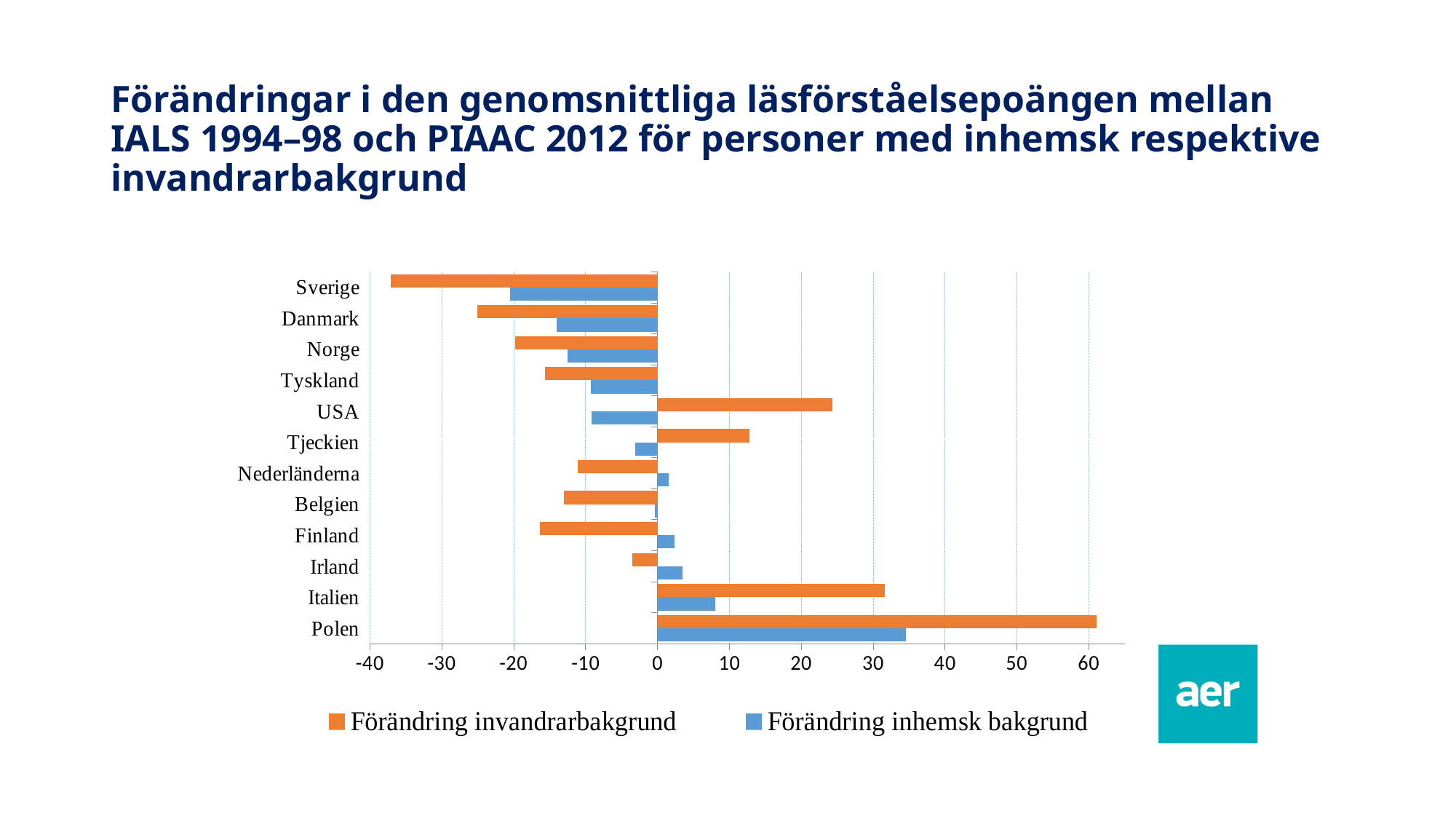
Is the Förändring invandrarbakgrund value for USA greater or less than 20? greater Which has the larger Förändring invandrarbakgrund value, Italien or USA? Italien Is the Förändring invandrarbakgrund value for Polen greater or less than 50? greater How many countries are listed on the chart? 12 Which country has the highest value for Förändring inhemsk bakgrund? Polen Which colour represents Förändring invandrarbakgrund in the legend? Orange Is the Förändring invandrarbakgrund value for Sverige greater or less than -30? less Which country has the lowest value for Förändring invandrarbakgrund? Sverige Which country has the highest value for Förändring invandrarbakgrund? Polen Which country has the lowest value for Förändring inhemsk bakgrund? Sverige How many series does the legend list? 2 What kind of chart is shown on the slide? Bar chart